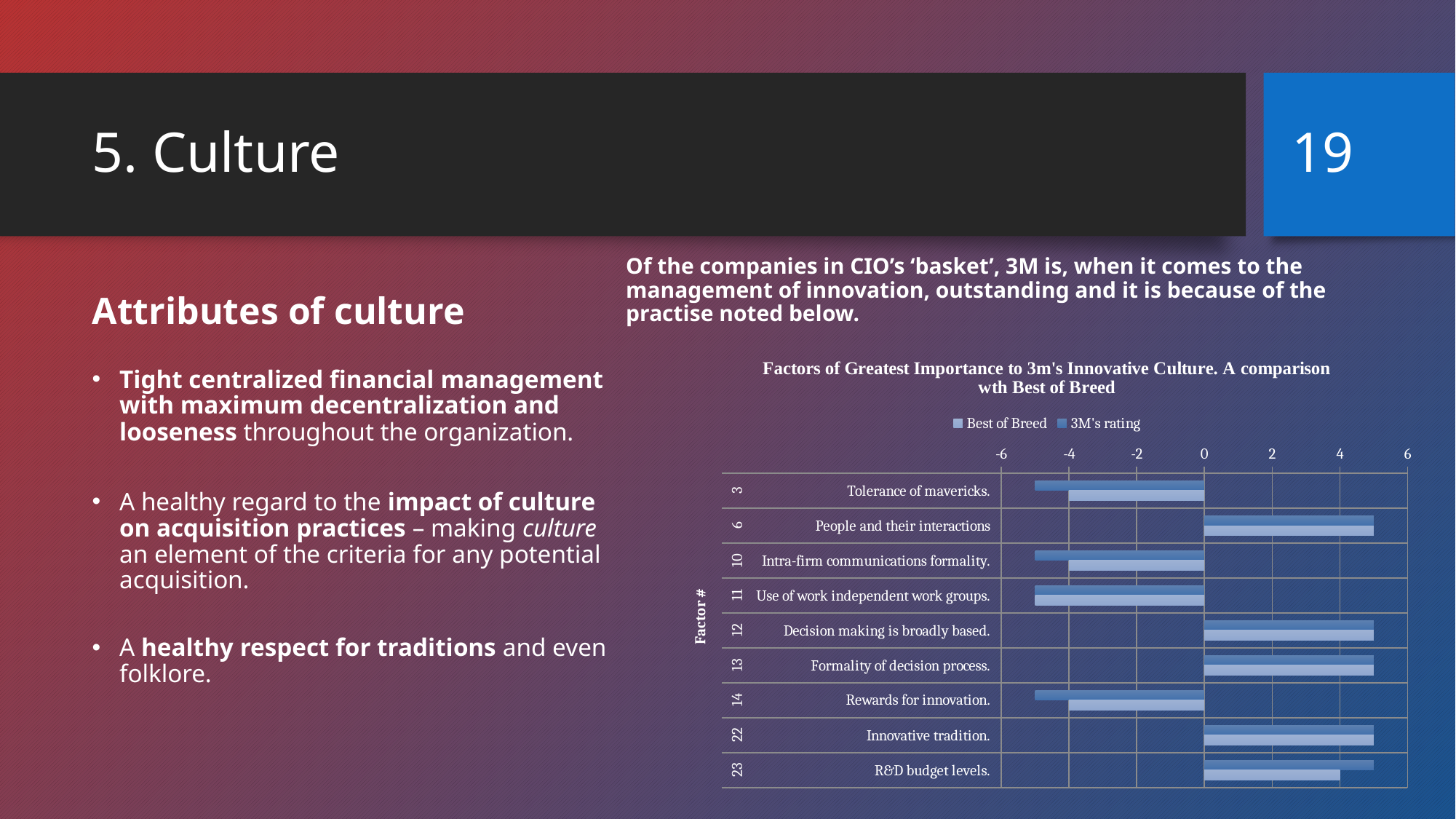
Which factor number is shown for 'R&D budget levels.'? 23 Are the values for 'Tolerance of mavericks.' greater or less than -2? less Are the values for 'People and their interactions' greater or less than 2? greater Are the values for 'Rewards for innovation.' greater or less than 0? less How many factors in the chart have negative values? 4 What is the title of the chart? Factors of Greatest Importance to 3m's Innovative Culture. A comparison wth Best of Breed What kind of chart is shown on the slide? Bar chart What are the two series named in the chart legend? Best of Breed and 3M's rating How many factors (categories) are plotted in the chart? 9 How many series does the chart legend list? 2